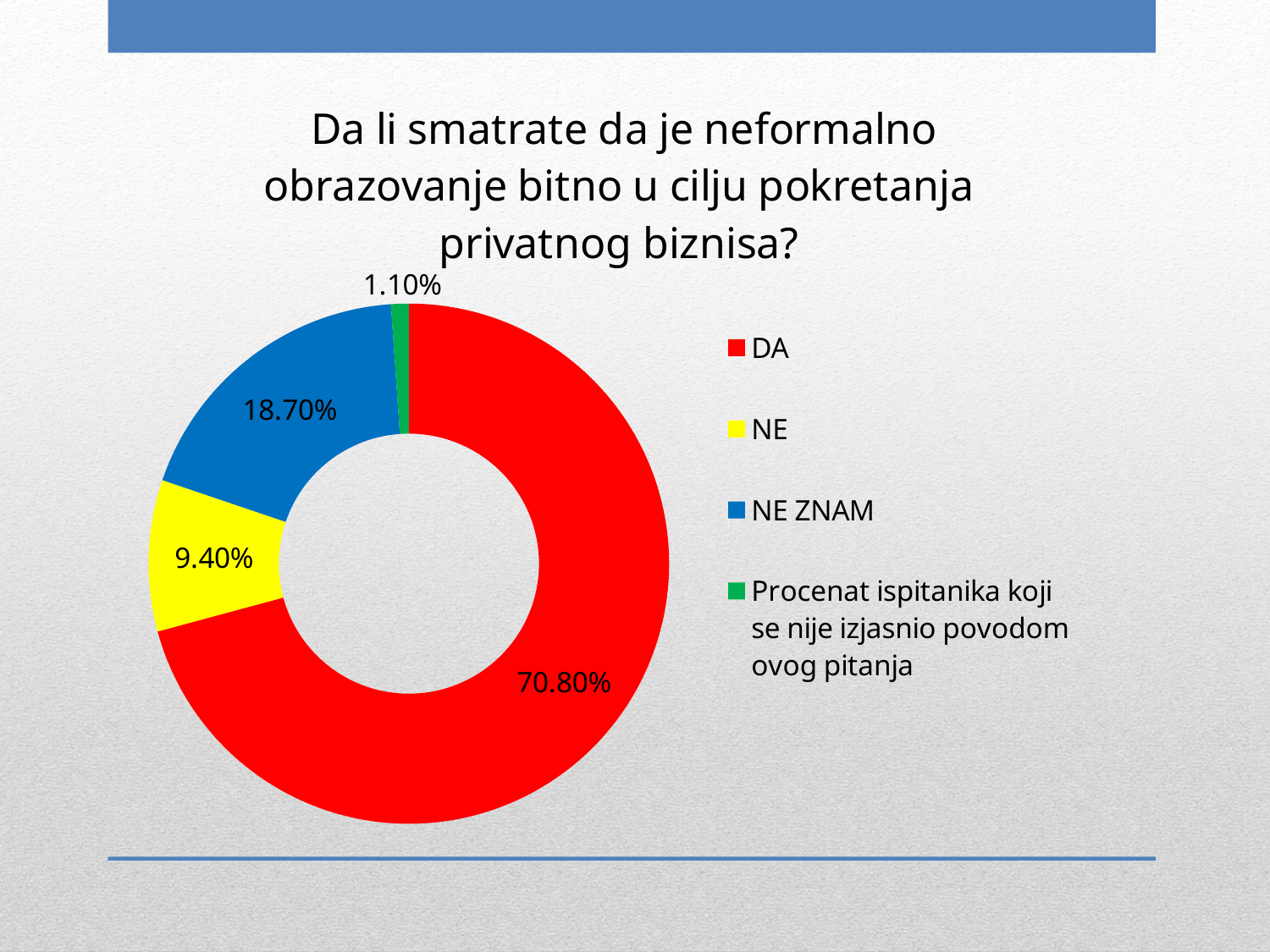
What is the difference in percentage points between DA and NE ZNAM? 52.10% What percentage of respondents answered NE? 9.40% What percentage of respondents answered DA? 70.80% How many categories are shown in the chart? 4 Which category has the smallest share of the chart? Procenat ispitanika koji se nije izjasnio povodom ovog pitanja What colour represents the DA category in the chart? Red What percentage of respondents answered NE ZNAM? 18.70% Which category has the largest share of the chart? DA What percentage of respondents did not answer the question (Procenat ispitanika koji se nije izjasnio povodom ovog pitanja)? 1.10% Which is larger, the share for NE or the share for NE ZNAM? NE ZNAM What is the difference in percentage points between NE ZNAM and NE? 9.30% What kind of chart is shown on the slide? Doughnut chart